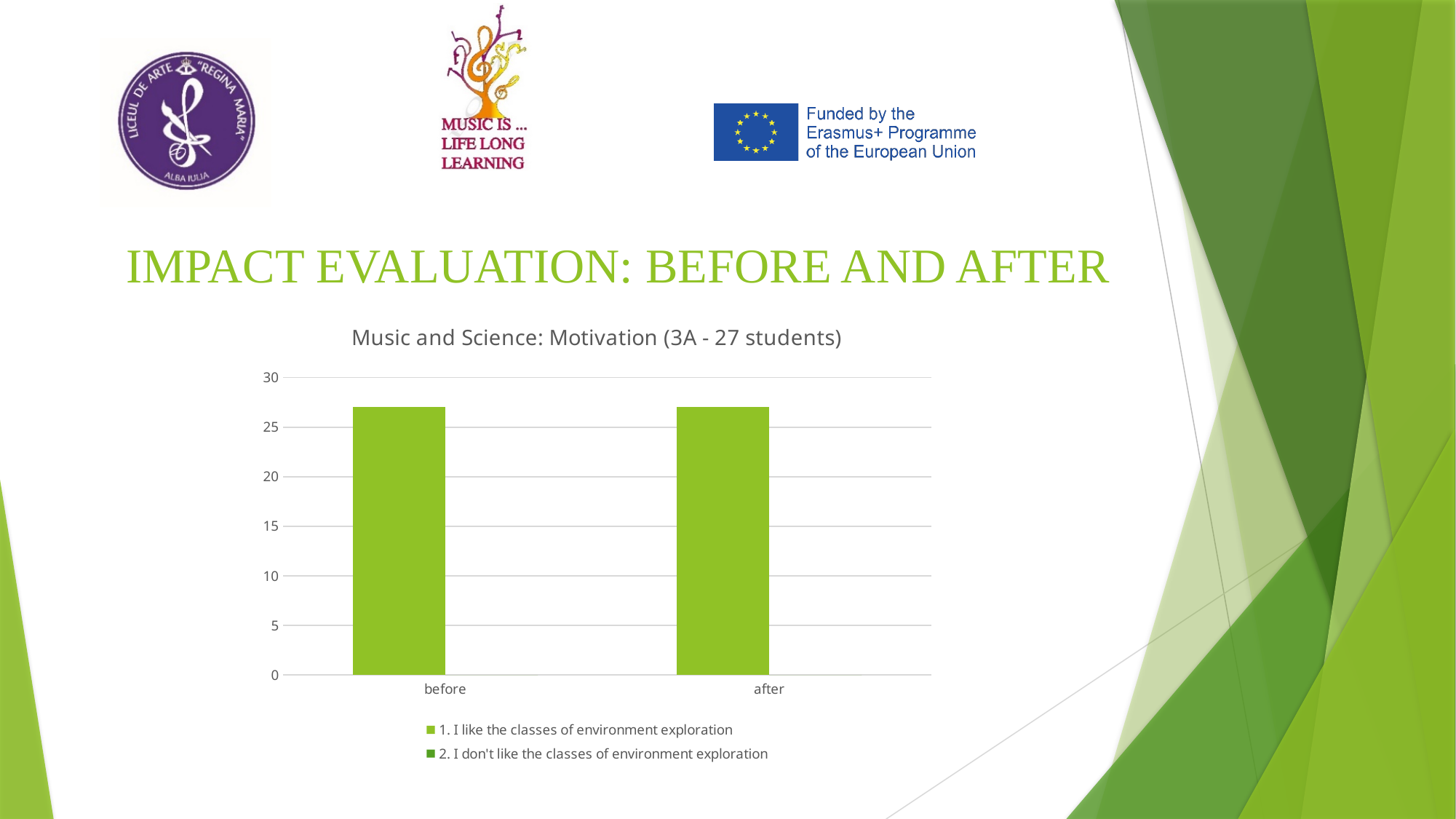
Is the value for 'after' for the series '1. I like the classes of environment exploration' greater or less than 30? less What is the title of the chart? Music and Science: Motivation (3A - 27 students) Does the value for '1. I like the classes of environment exploration' rise, fall or stay the same from 'before' to 'after'? stays the same What is the highest value shown on the y axis of the chart? 30 Is the value for 'before' for the series '1. I like the classes of environment exploration' greater or less than 20? greater How many series does the chart legend list? 2 How many categories are shown on the x axis of the chart? 2 What is the first series listed in the chart legend? 1. I like the classes of environment exploration Is the value for 'before' for the series '1. I like the classes of environment exploration' greater or less than 25? greater What kind of chart is shown on the slide? bar chart